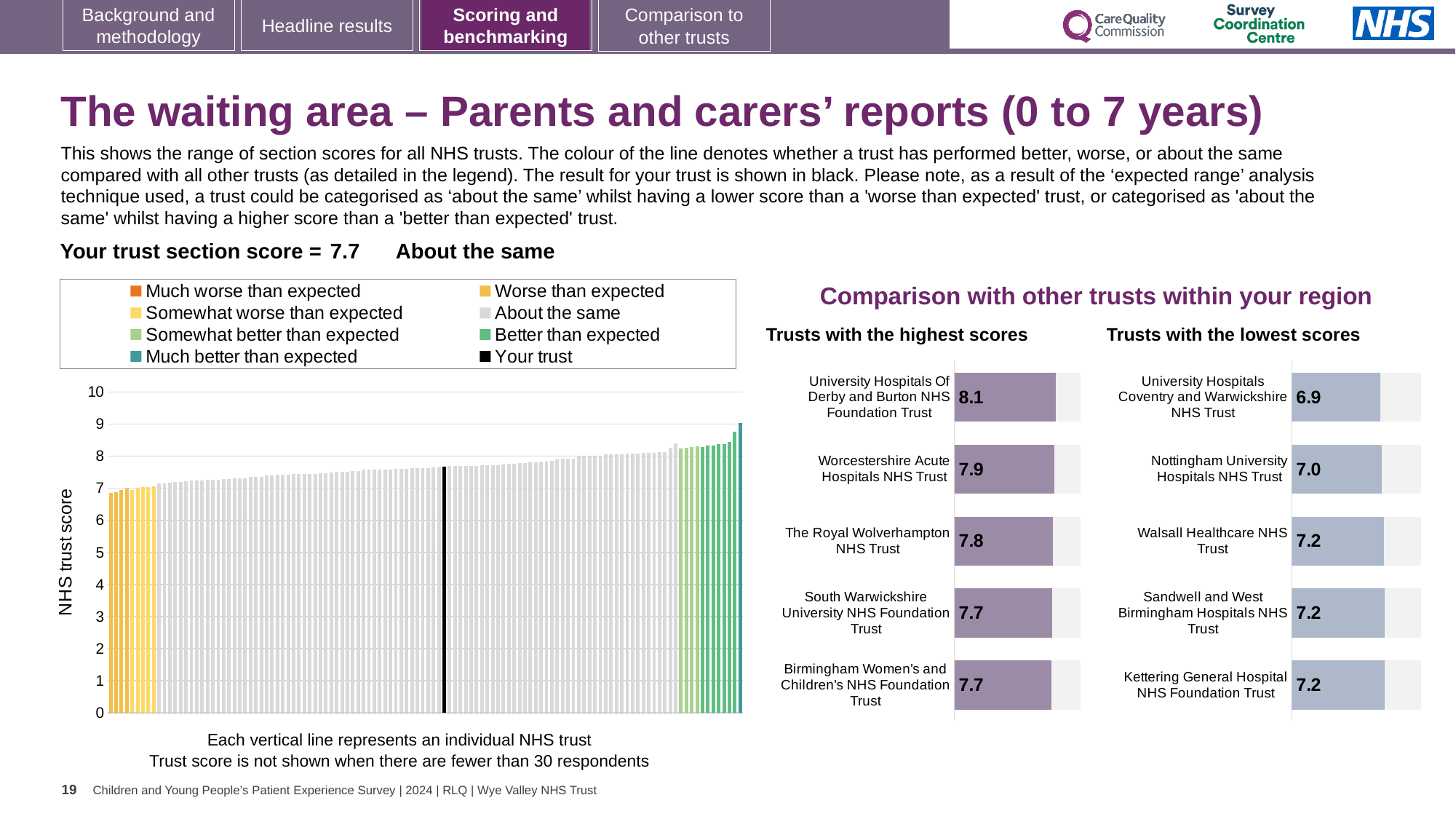
What kind of chart is the large chart on the left showing NHS trust scores? bar chart In the large chart on the left, is the value of the tallest bar at the far right greater or less than 8? greater In the 'Trusts with the lowest scores' chart, which has the larger score: Nottingham University Hospitals NHS Trust or Walsall Healthcare NHS Trust? Walsall Healthcare NHS Trust In the 'Trusts with the highest scores' chart, what is the difference between the scores of University Hospitals Of Derby and Burton NHS Foundation Trust and Worcestershire Acute Hospitals NHS Trust? 0.2 In the large chart on the left, is the value of the black bar (your trust) greater or less than 7? greater In the 'Trusts with the highest scores' chart, what is the score for University Hospitals Of Derby and Burton NHS Foundation Trust? 8.1 How many trusts are shown in the 'Trusts with the lowest scores' chart? 5 In the large chart on the left, what is the label on the vertical axis? NHS trust score How many entries does the legend above the large chart on the left list? 8 In the 'Trusts with the highest scores' chart, which trust has the highest score? University Hospitals Of Derby and Burton NHS Foundation Trust In the 'Trusts with the lowest scores' chart, which trust has the lowest score? University Hospitals Coventry and Warwickshire NHS Trust In the large chart on the left, do the bar heights rise or fall from left to right? rise